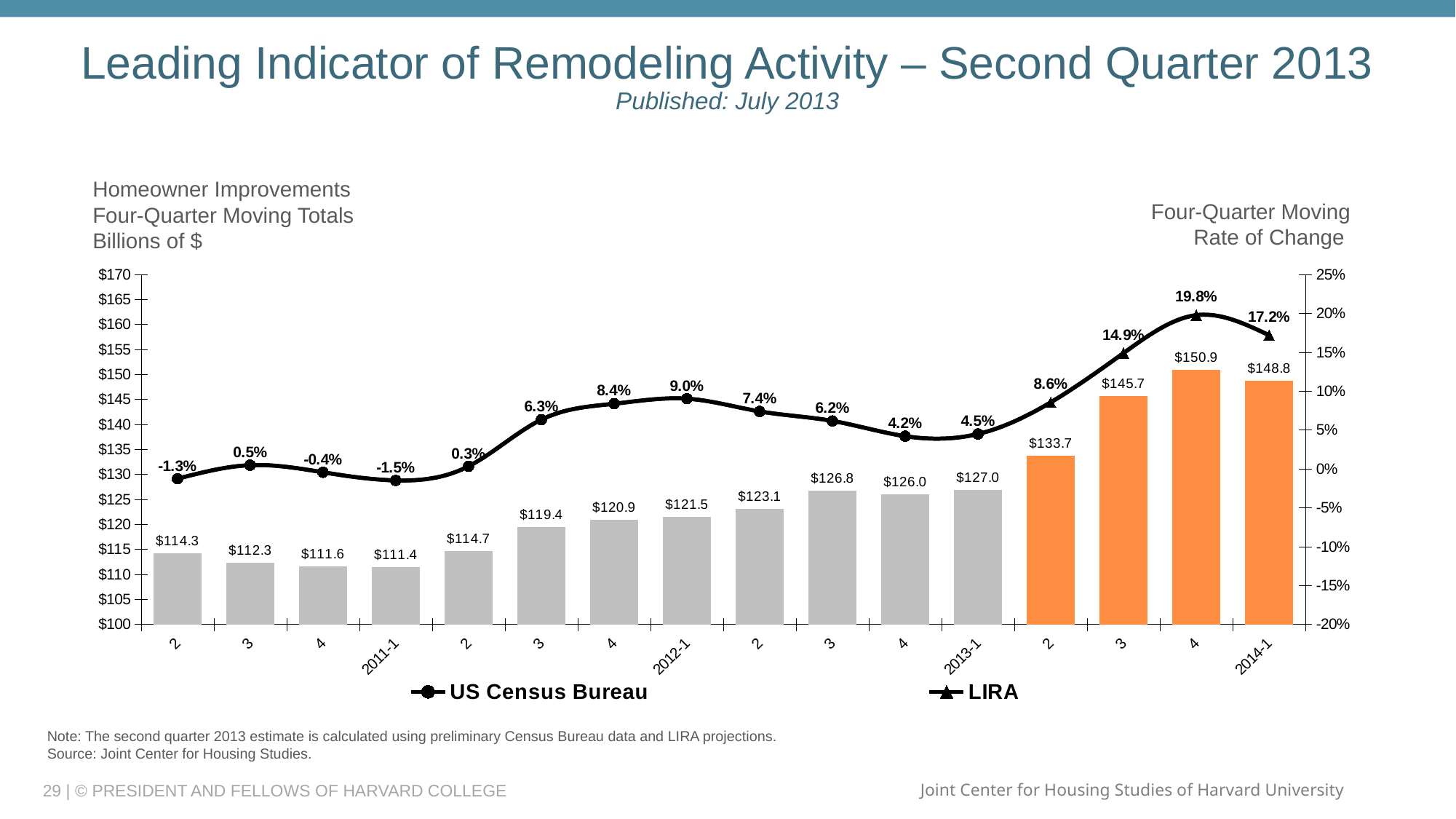
What kind of chart is shown on the slide? A combined bar and line chart How many bars are plotted on the chart? 16 What is the four-quarter moving rate of change at 2012-1? 9.0% What is the highest four-quarter moving rate of change shown on the line? 19.8% What are the two series named in the legend? US Census Bureau and LIRA What is the highest four-quarter moving total shown by the bars? $150.9 What is the lowest four-quarter moving total shown by the bars? $111.4 What is the four-quarter moving total for 2013-1? $127.0 What is the lowest four-quarter moving rate of change shown on the line? -1.5% Which has the larger four-quarter moving total, 2012-1 or 2013-1? 2013-1 How many series does the legend list? 2 What is the difference between the four-quarter moving totals for 2014-1 and 2013-1? $21.8